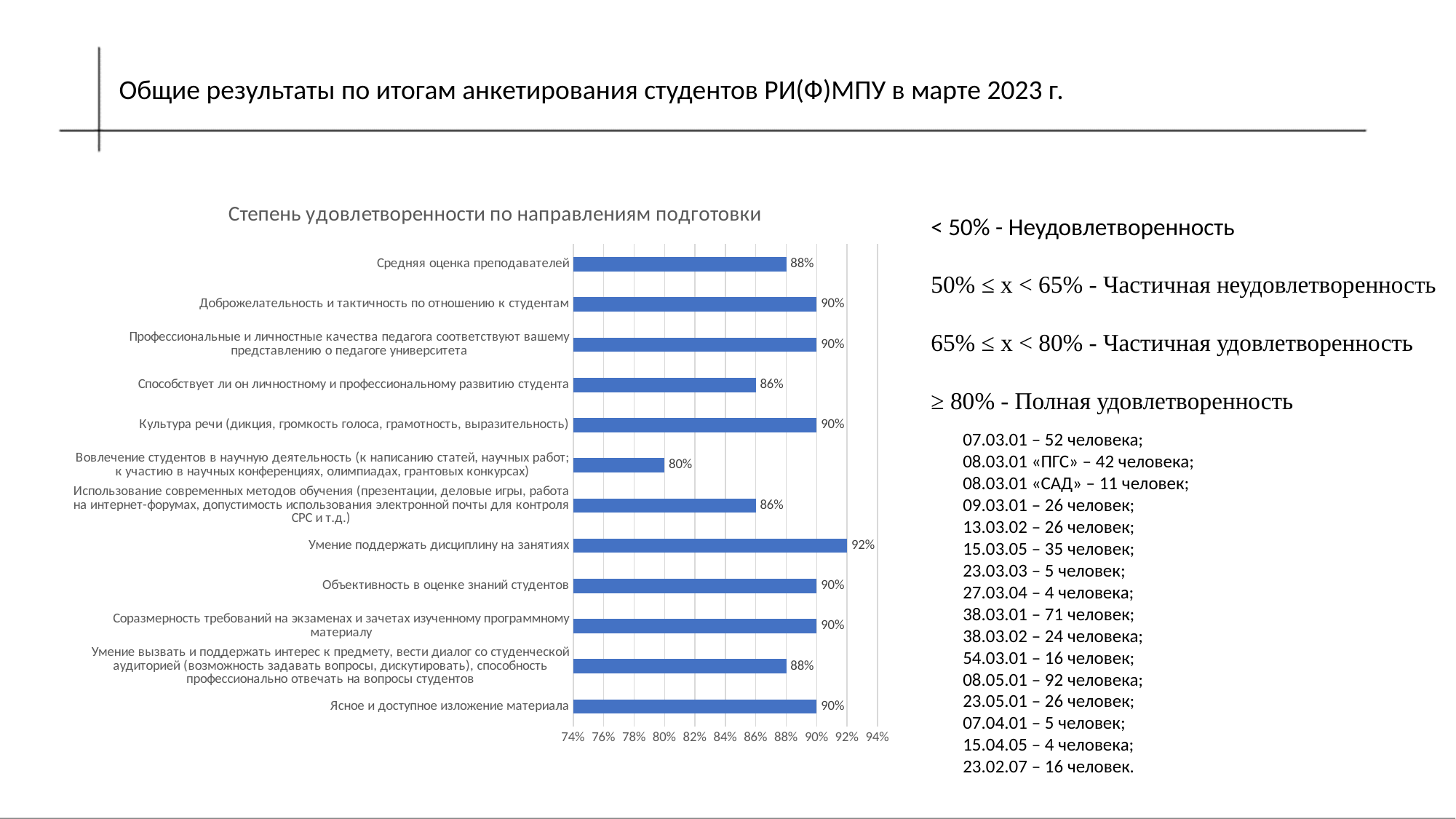
What is the title of the chart? Степень удовлетворенности по направлениям подготовки How many categories are shown in the chart? 12 Which category has the lowest value? Вовлечение студентов в научную деятельность What is the value for "Умение поддержать дисциплину на занятиях"? 92% What kind of chart is shown on the slide? Bar chart What is the difference between the values for "Умение поддержать дисциплину на занятиях" and "Вовлечение студентов в научную деятельность"? 12% What is the value for "Вовлечение студентов в научную деятельность"? 80% Which category has the highest value? Умение поддержать дисциплину на занятиях Which is larger: the value for "Культура речи" or the value for "Средняя оценка преподавателей"? Культура речи What is the value for "Способствует ли он личностному и профессиональному развитию студента"? 86% What is the value for "Средняя оценка преподавателей"? 88% What is the value for "Ясное и доступное изложение материала"? 90%